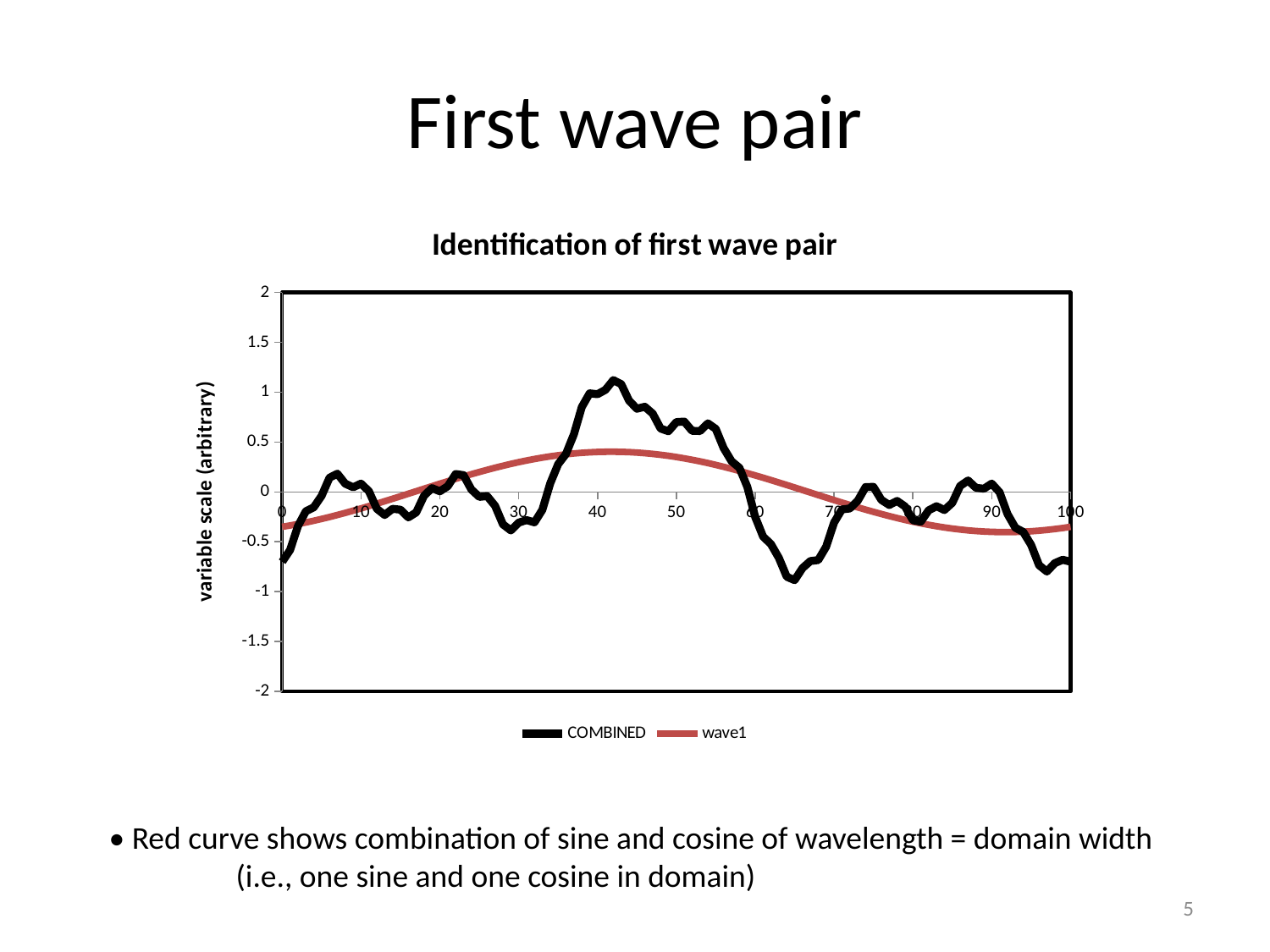
Is the value of the COMBINED series at x = 40 greater or less than 0.5? greater Is the peak value of the wave1 series greater or less than 0.5? less At x = 40, which series has the higher value, COMBINED or wave1? COMBINED What is the title of the chart? Identification of first wave pair At x = 65, which series has the higher value, COMBINED or wave1? wave1 Is the value of the COMBINED series at x = 65 greater or less than -0.5? less How many series does the chart legend list? 2 What kind of chart is shown on the slide? line chart Does the wave1 series rise or fall between x = 50 and x = 90? fall What is the label on the vertical axis of the chart? variable scale (arbitrary) Does the wave1 series rise or fall between x = 0 and x = 40? rise